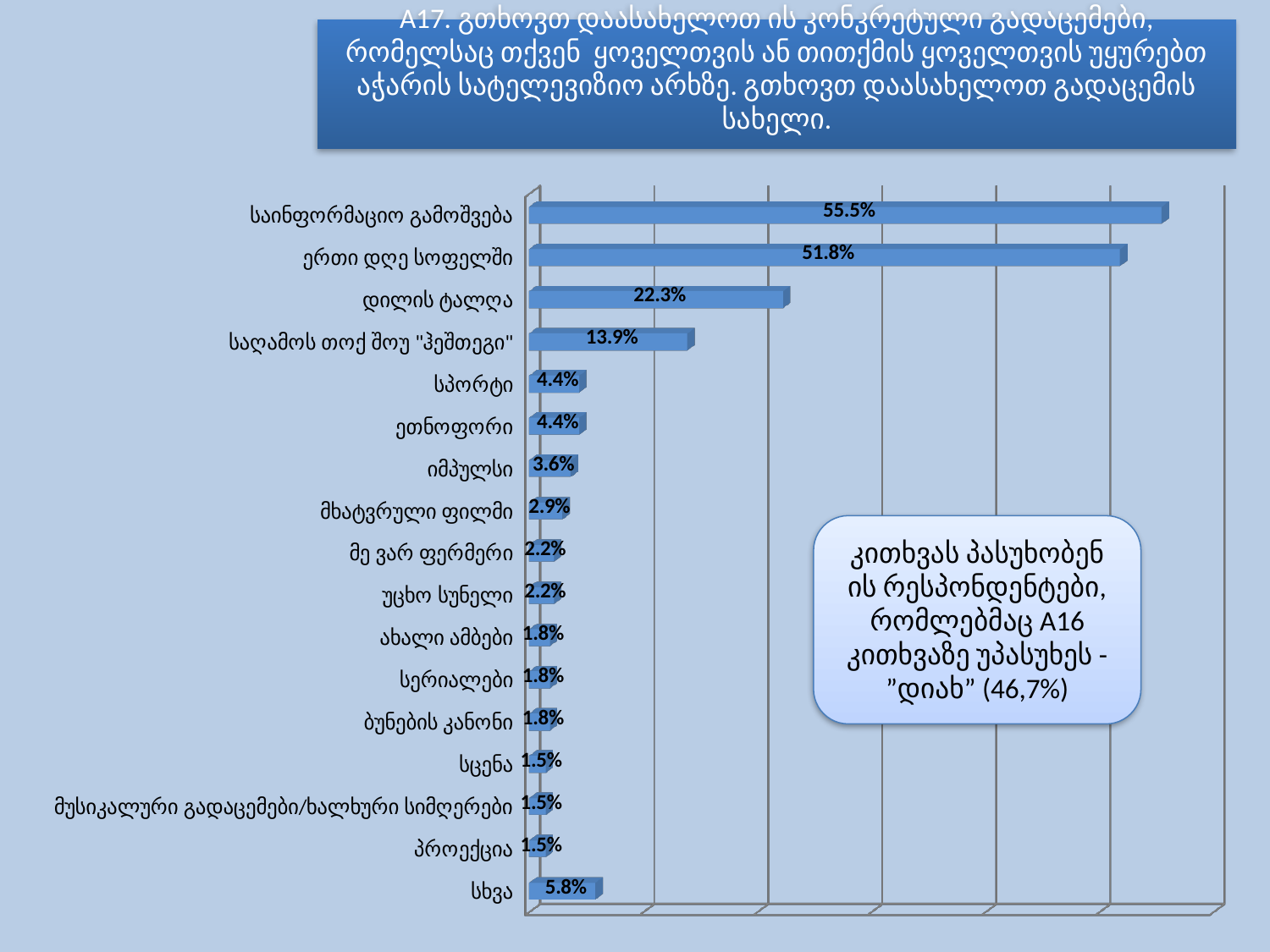
What is the value for დილის ტალღა? 22.3% Which is larger, the value for დილის ტალღა or the value for საღამოს თოქ შოუ "ჰეშთეგი"? დილის ტალღა What is the value for იმპულსი? 3.6% Which category has the highest value? საინფორმაციო გამოშვება What is the value for ერთი დღე სოფელში? 51.8% What is the value for სხვა? 5.8% How many categories are shown in the chart? 17 What is the value for საღამოს თოქ შოუ "ჰეშთეგი"? 13.9% What is the difference between the values for სხვა and სპორტი? 1.4% What is the value for საინფორმაციო გამოშვება? 55.5% What kind of chart is shown on the slide? bar chart What is the difference between the values for საინფორმაციო გამოშვება and ერთი დღე სოფელში? 3.7%